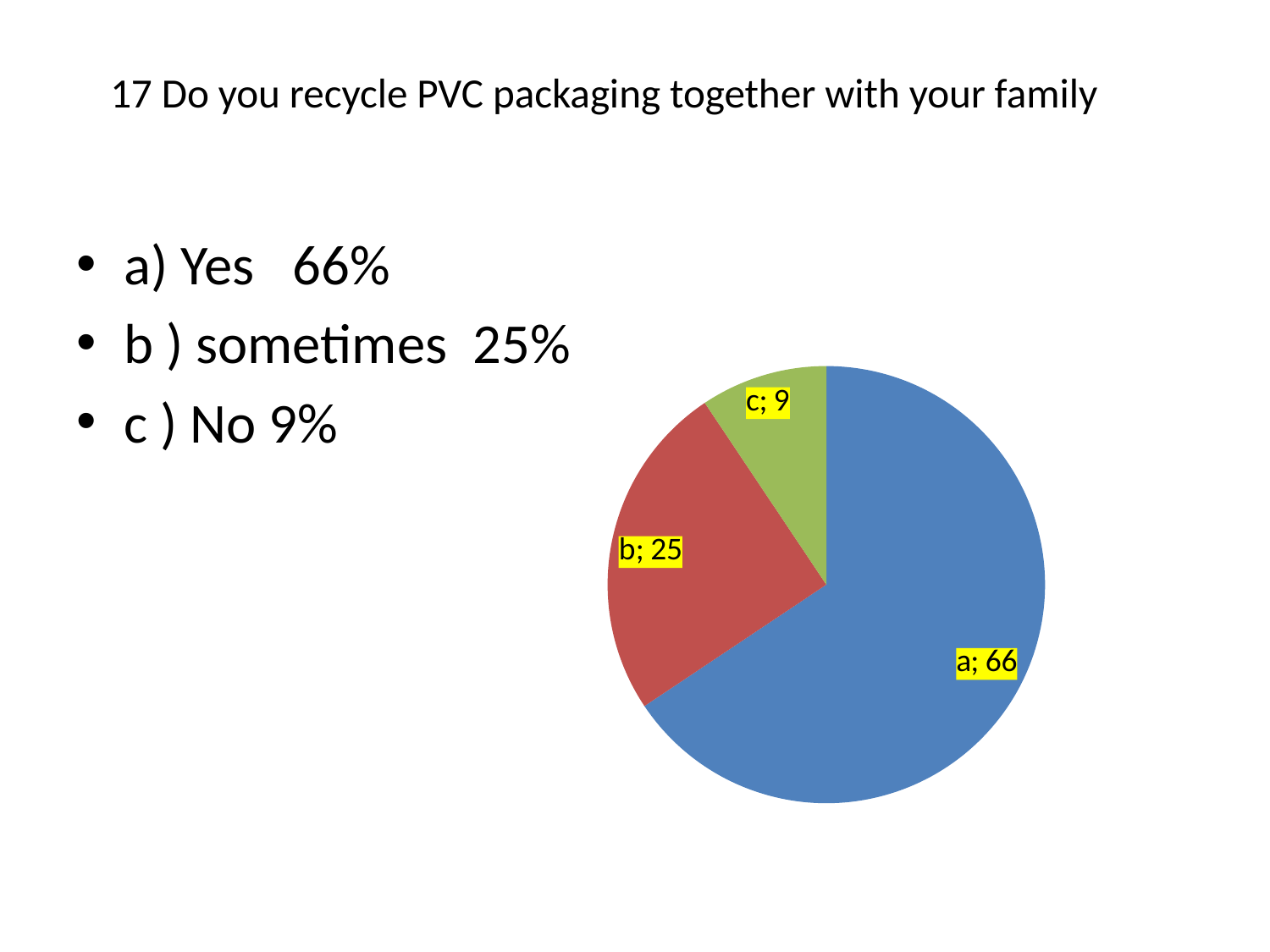
What kind of chart is shown on the slide? pie chart What is the total of all the slice values in the pie chart? 100 Which slice of the pie chart is the largest? a What value is shown for slice a in the pie chart? 66 What colour is slice a in the pie chart? blue Which slice of the pie chart is the smallest? c How many slices does the pie chart have? 3 Which is larger, the value for slice b or slice c? b What value is shown for slice b in the pie chart? 25 What value is shown for slice c in the pie chart? 9 What is the difference between the values for slices a and b? 41 What is the difference between the values for slices b and c? 16